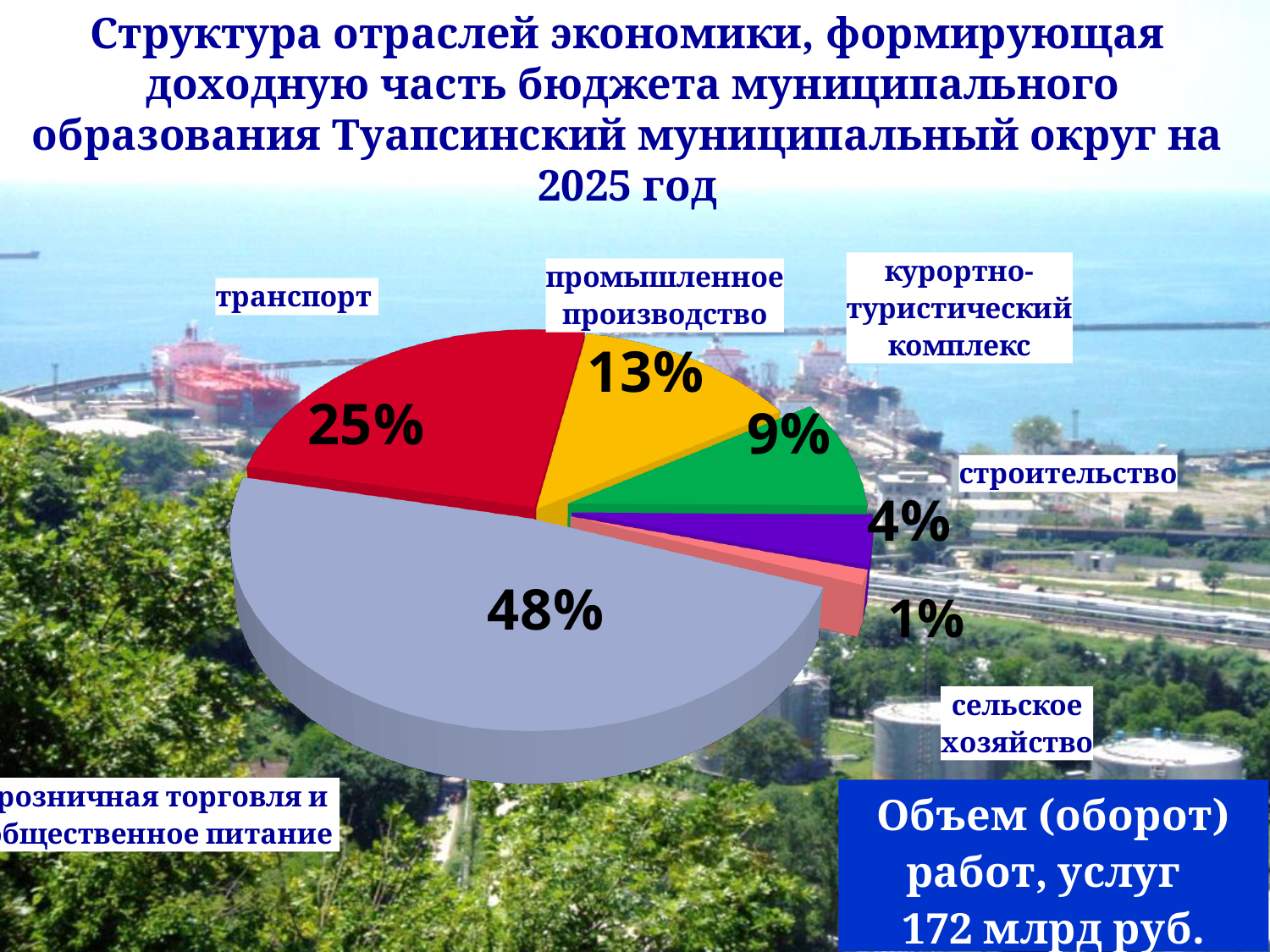
What is the value shown for транспорт? 25% Which is larger, the share of курортно-туристический комплекс or the share of строительство? курортно-туристический комплекс How many sectors (slices) are shown in the pie chart? 6 Which sector has the smallest share of the pie? сельское хозяйство What kind of chart is shown on the slide? pie chart What is the value shown for строительство? 4% What is the value shown for сельское хозяйство? 1% What is the value shown for курортно-туристический комплекс? 9% What is the difference between the shares of транспорт and промышленное производство? 12% What is the value shown for промышленное производство? 13% Which sector has the largest share of the pie? розничная торговля и общественное питание What share of the pie does розничная торговля и общественное питание have? 48%